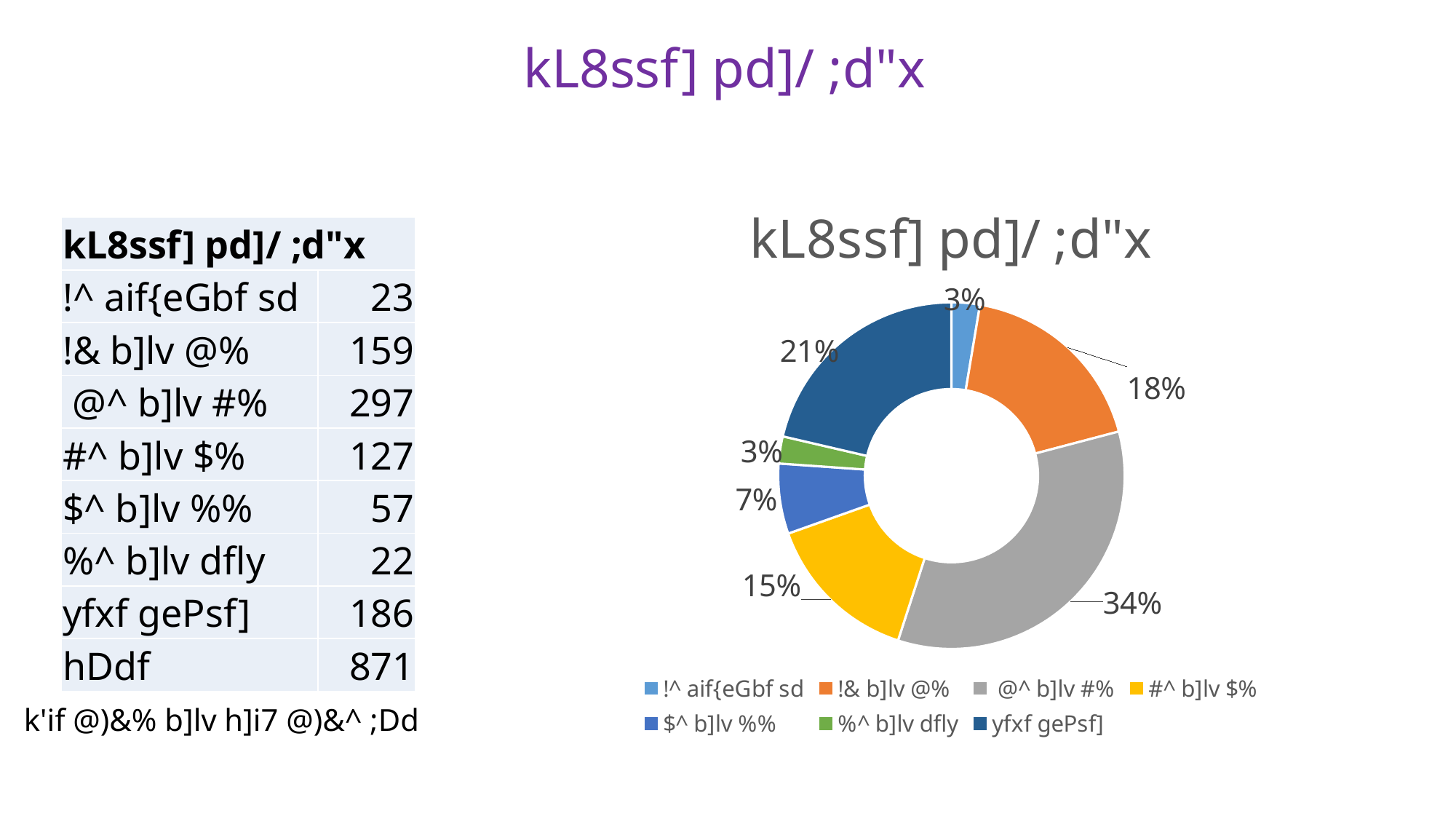
Which slice is larger, "yfxf gePsf]" or "!& b]lv @%"? yfxf gePsf] What share of the doughnut chart does "@^ b]lv #%" take? 34% What share of the doughnut chart does "$^ b]lv %%" take? 7% How many entries does the chart legend list? 7 What is the title of the chart? kL8ssf] pd]/ ;d"x What share of the doughnut chart does "yfxf gePsf]" take? 21% What kind of chart is shown on the slide? doughnut chart How many slices does the doughnut chart have? 7 What is the difference in percentage points between the "@^ b]lv #%" slice and the "#^ b]lv $%" slice? 19 Which category has the largest slice in the doughnut chart? @^ b]lv #%